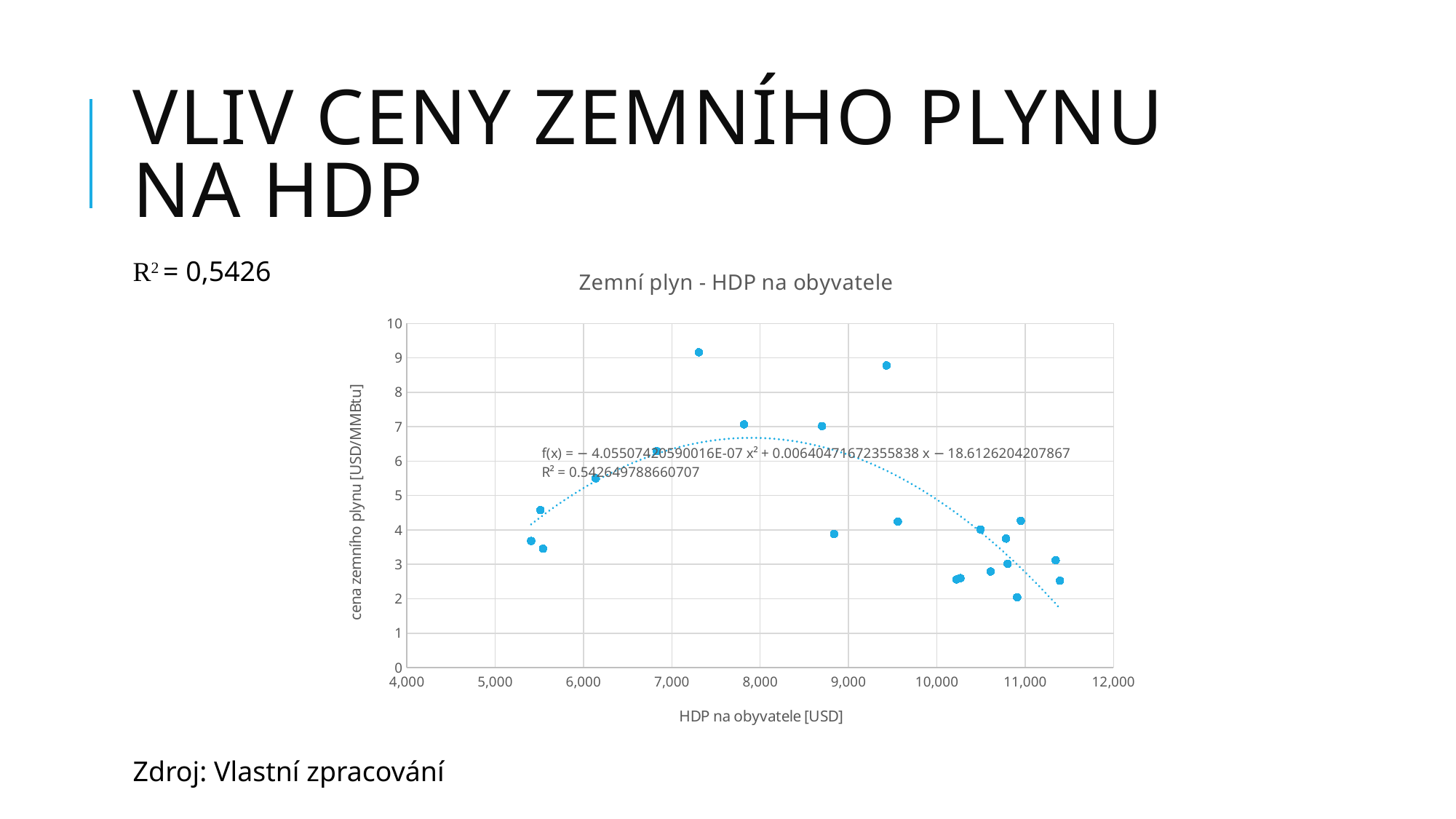
What is the label of the vertical axis of the chart? cena zemního plynu [USD/MMBtu] Does the dotted trendline rise or fall as GDP per capita increases from 10,000 to 11,000 USD? fall Is the natural gas price for the point at roughly 6,100 USD GDP per capita greater or less than 5? greater What is the title of the chart? Zemní plyn - HDP na obyvatele Is the highest plotted point located at a GDP per capita greater or less than 8,000 USD? less Does the dotted trendline rise or fall as GDP per capita increases from 5,500 to 7,000 USD? rise Is the lowest plotted natural gas price in the chart greater or less than 3? less What R² value is printed inside the chart next to the trendline equation? R² = 0.542649788660707 What kind of chart is shown on the slide? scatter chart